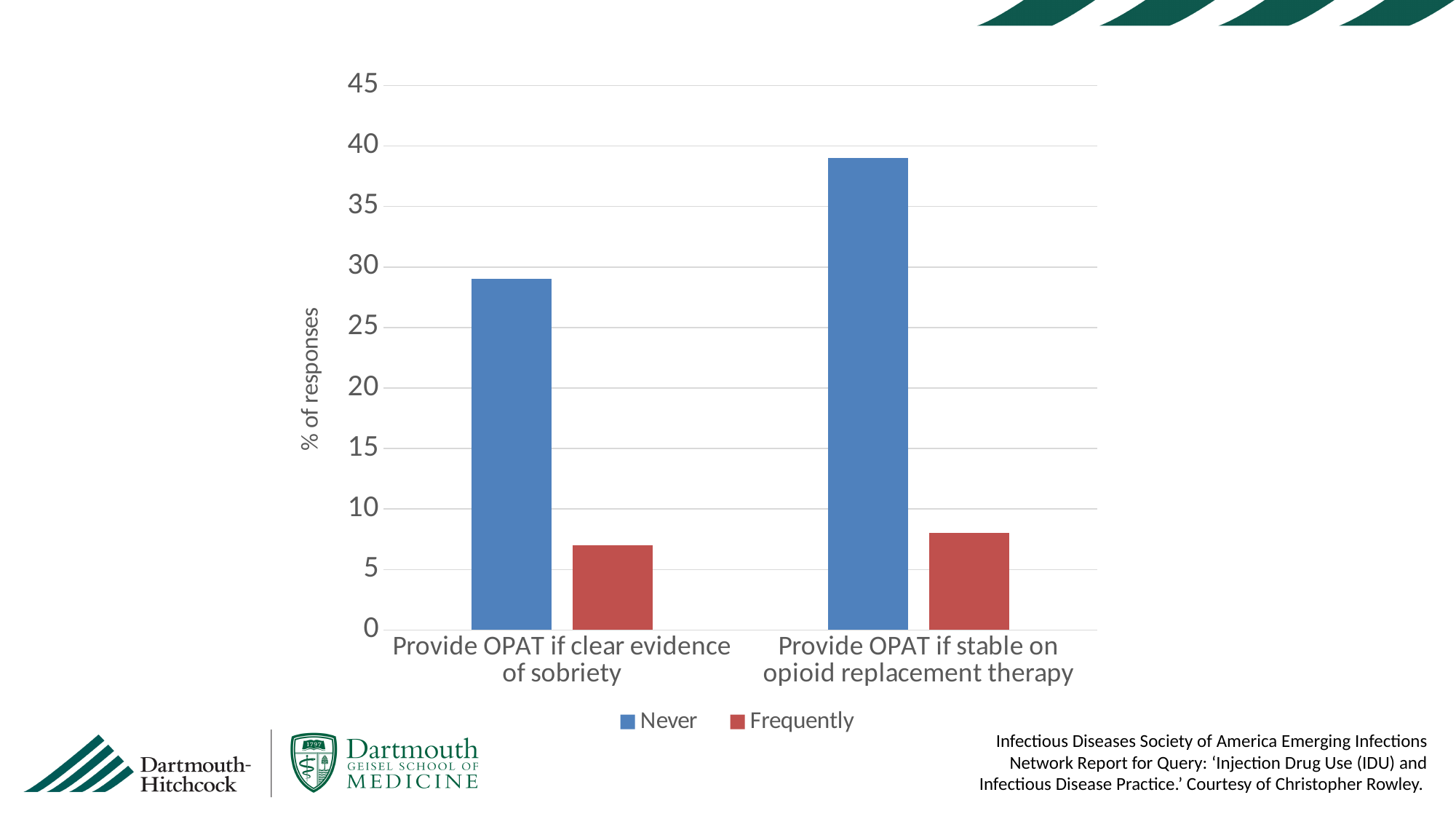
Which bar is the lowest on the chart? Frequently for Provide OPAT if clear evidence of sobriety For 'Provide OPAT if clear evidence of sobriety', which is larger, the Never value or the Frequently value? Never How many series does the legend list? 2 How many categories are shown on the x axis? 2 Which series is shown in blue? Never What kind of chart is shown on the slide? bar chart What is the label of the y axis? % of responses Is the Never value for 'Provide OPAT if stable on opioid replacement therapy' greater or less than 35? greater Is the Never value for 'Provide OPAT if clear evidence of sobriety' greater or less than 25? greater Is the Frequently value for 'Provide OPAT if stable on opioid replacement therapy' greater or less than 10? less Which category has the higher Never value? Provide OPAT if stable on opioid replacement therapy